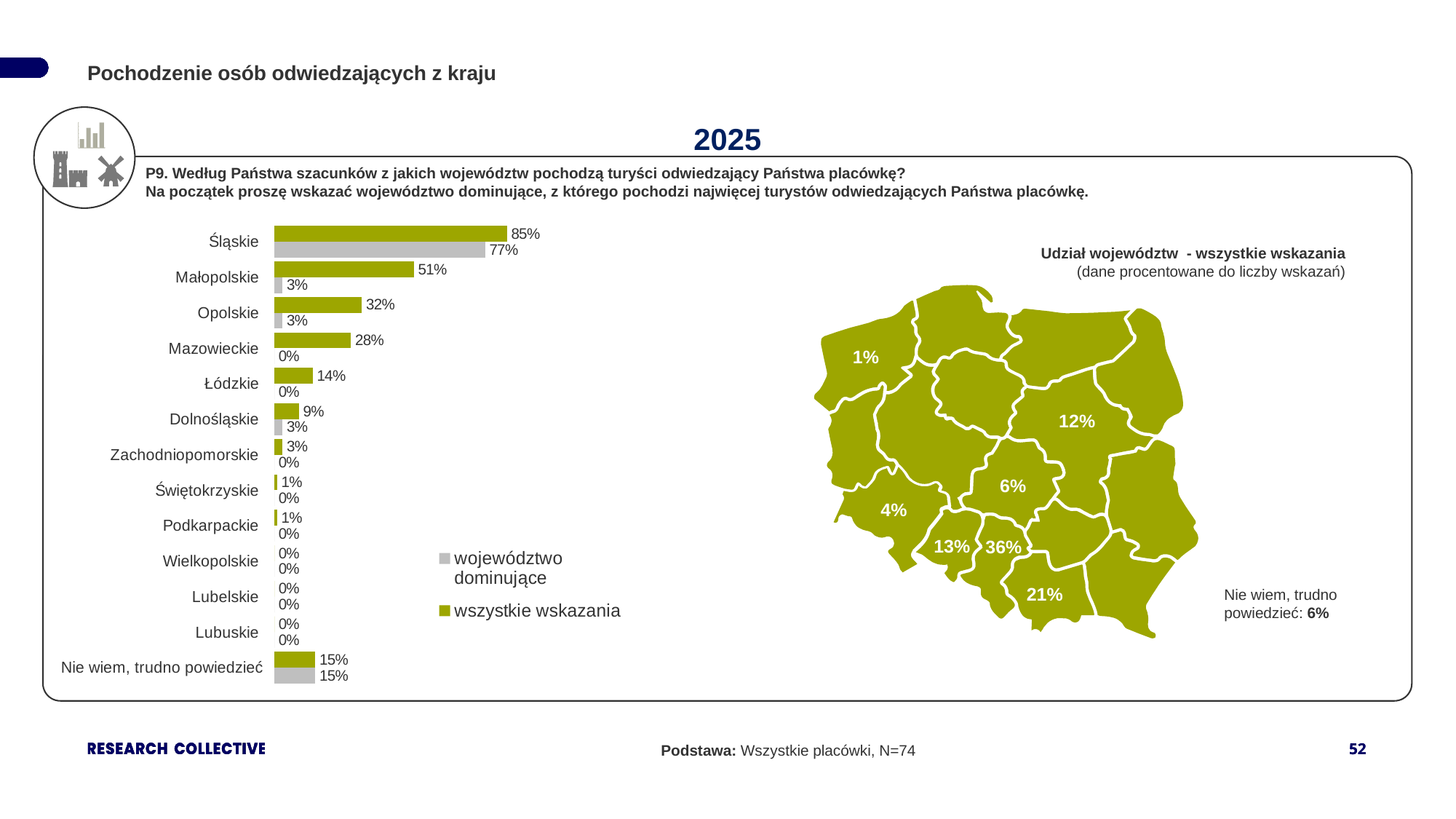
How many series does the legend of the bar chart list? 2 What are the two series names listed in the legend? województwo dominujące; wszystkie wskazania What is the 'wszystkie wskazania' value for Małopolskie? 51% What is the difference between the two series values for Śląskie? 8% Which is larger: the 'wszystkie wskazania' value for Mazowieckie or for Łódzkie? Mazowieckie What is the value for Śląskie in the 'wszystkie wskazania' series? 85% Which category has the highest 'wszystkie wskazania' value? Śląskie What is the 'województwo dominujące' value for Dolnośląskie? 3% What is the difference between the 'wszystkie wskazania' values for Małopolskie and Opolskie? 19% What kind of chart is used to show the voivodeship data? Bar chart What is the value for Śląskie in the 'województwo dominujące' series? 77% How many categories are shown on the bar chart? 13